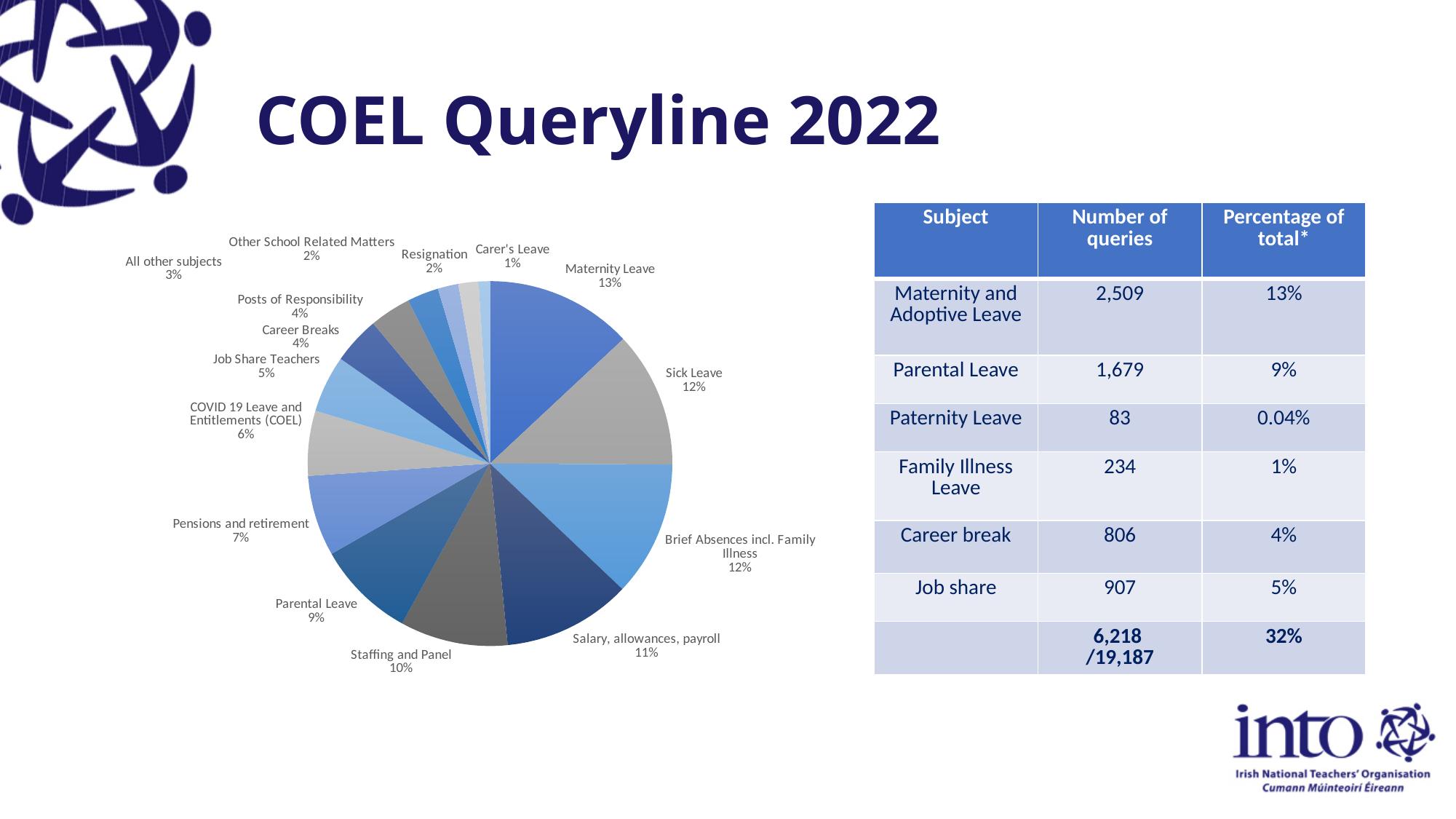
What share of the pie does Maternity Leave represent? 13% What percentage is shown for Staffing and Panel in the pie chart? 10% What type of chart is shown on the slide? Pie chart What percentage is shown for COVID 19 Leave and Entitlements (COEL)? 6% What is the difference in percentage points between Maternity Leave and Parental Leave? 4 Which category has the largest slice of the pie chart? Maternity Leave How many slices does the pie chart have? 15 What percentage is shown for Resignation in the pie chart? 2% Which category has the smallest slice of the pie chart? Carer's Leave What is the title of the slide containing the pie chart? COEL Queryline 2022 Which is larger in the pie chart, Salary, allowances, payroll or Job Share Teachers? Salary, allowances, payroll What percentage is shown for Pensions and retirement? 7%